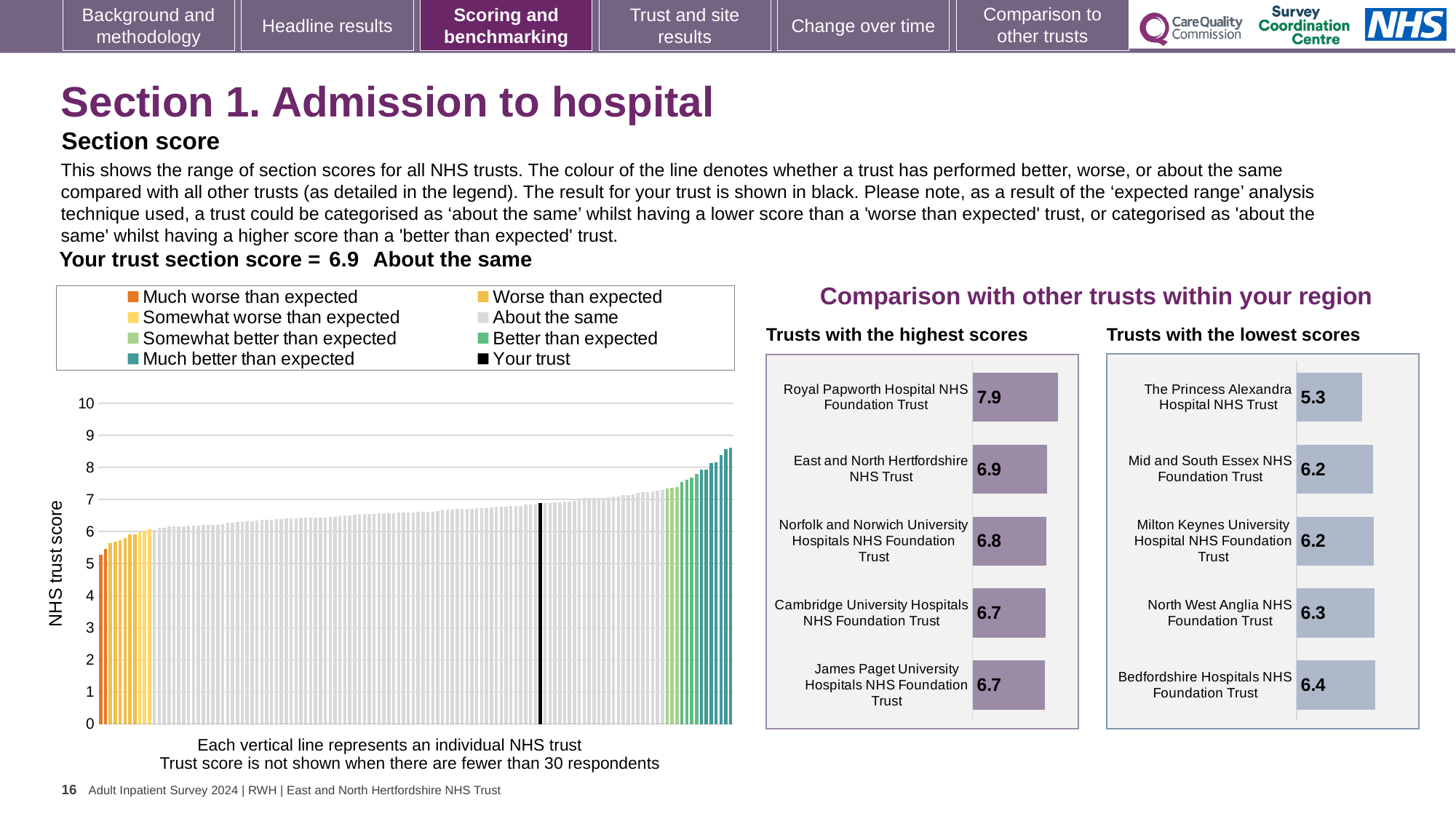
In the 'Trusts with the lowest scores' chart, which trust has the lowest score? The Princess Alexandra Hospital NHS Trust In the main NHS trust score chart on the left, is the value of the tallest bar greater or less than 8? greater How many trusts are shown in the 'Trusts with the highest scores' chart? 5 In the main NHS trust score chart on the left, what is the section score for your trust? 6.9 In the 'Trusts with the highest scores' chart, which trust has the highest score? Royal Papworth Hospital NHS Foundation Trust In the 'Trusts with the lowest scores' chart, what is the score for Bedfordshire Hospitals NHS Foundation Trust? 6.4 In the 'Trusts with the highest scores' chart, what is the difference between the scores of Royal Papworth Hospital NHS Foundation Trust and East and North Hertfordshire NHS Trust? 1.0 What kind of chart is the main NHS trust score chart on the left? bar chart In the 'Trusts with the highest scores' chart, what is the score for Royal Papworth Hospital NHS Foundation Trust? 7.9 In the 'Trusts with the lowest scores' chart, what is the score for The Princess Alexandra Hospital NHS Trust? 5.3 How many entries does the legend of the main NHS trust score chart on the left list? 8 In the 'Trusts with the lowest scores' chart, which has the higher score: North West Anglia NHS Foundation Trust or Bedfordshire Hospitals NHS Foundation Trust? Bedfordshire Hospitals NHS Foundation Trust